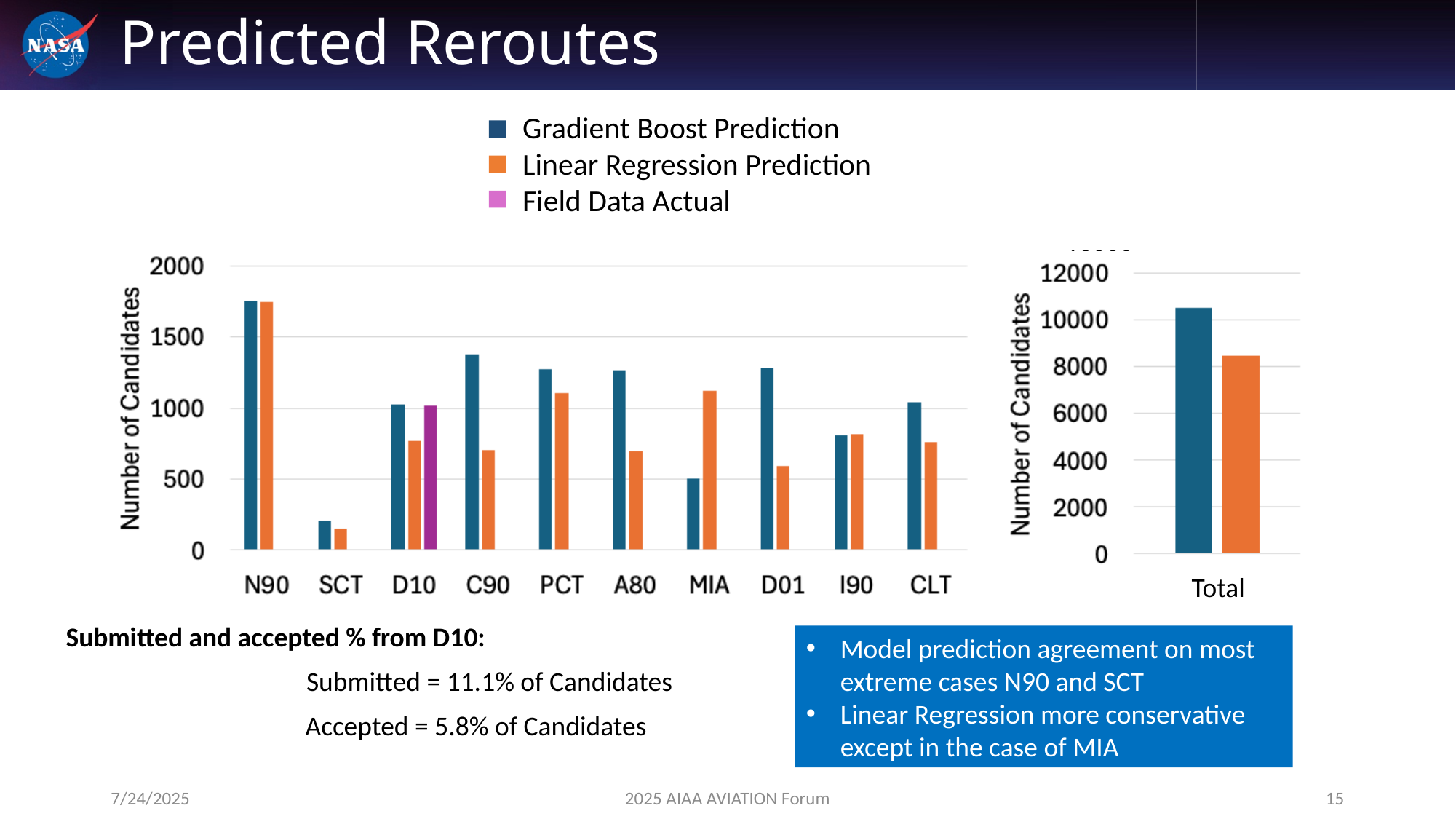
How many facility categories are shown on the x axis of the left chart? 10 How many series does the legend list? 3 In the left chart, is the Gradient Boost Prediction for MIA greater or less than 1000? less In the left chart, which facility has the highest Gradient Boost Prediction? N90 In the left chart, which facility is the only one with a Field Data Actual bar? D10 In the left chart, for MIA, which is larger: the Gradient Boost Prediction or the Linear Regression Prediction? Linear Regression Prediction In the Total chart on the right, is the Gradient Boost Prediction greater or less than 10000? greater In the left chart, is the Linear Regression Prediction for SCT greater or less than 500? less In the left chart, which facility has the lowest Gradient Boost Prediction? SCT In the Total chart on the right, which is larger: the Gradient Boost Prediction or the Linear Regression Prediction? Gradient Boost Prediction What kind of chart is the left chart showing Number of Candidates by facility? bar chart